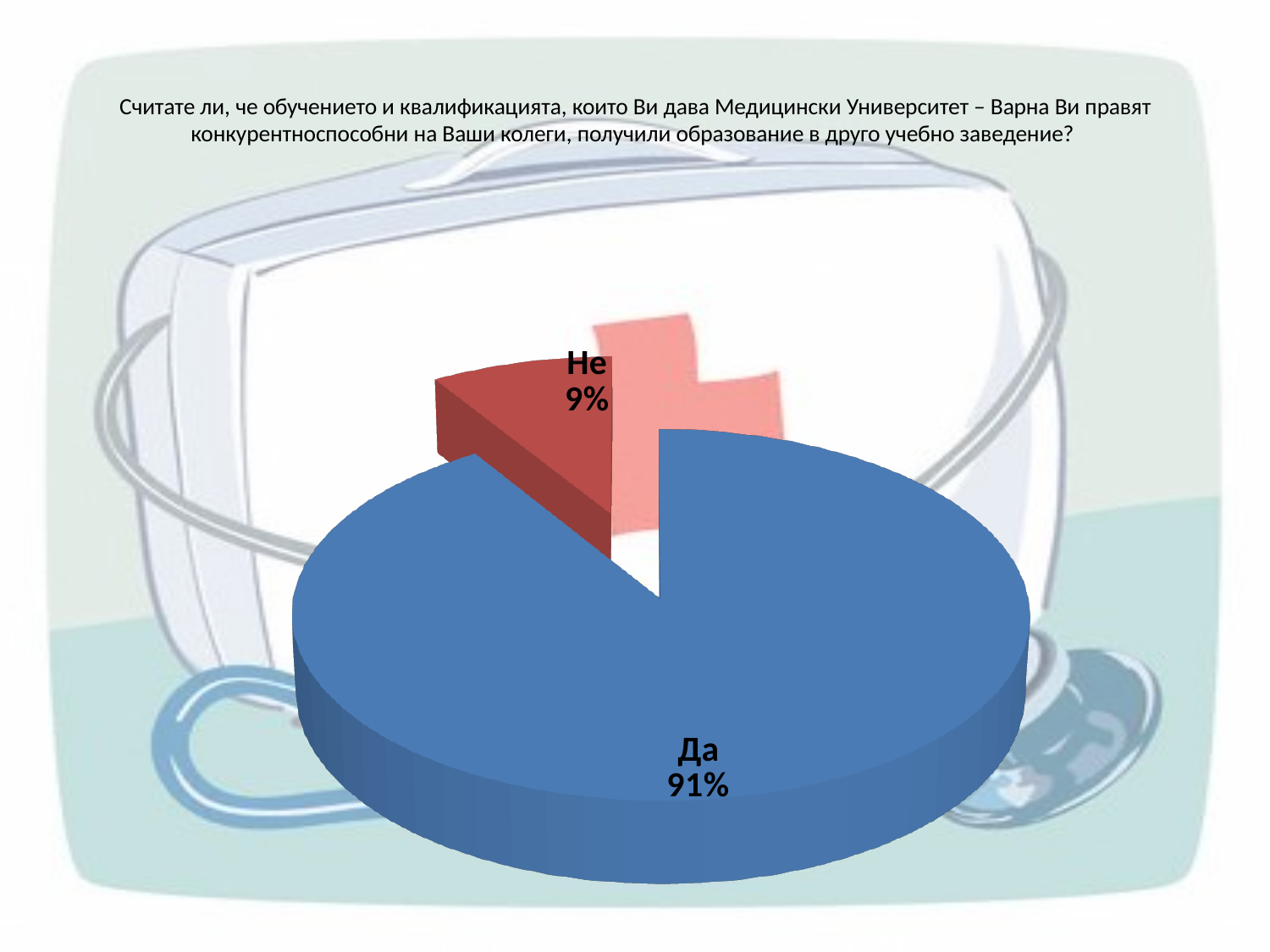
Which is larger, the "Да" slice or the "Не" slice? Да What colour is the "Да" slice? Blue What share of the pie does the "Не" slice represent? 9% What colour is the "Не" slice? Red What share of the pie does the "Да" slice represent? 91% What is the difference in percentage points between the "Да" and "Не" slices? 82 What kind of chart is shown on the slide? Pie chart Which slice is the smallest in the pie chart? Не How many slices does the pie chart have? 2 Which slice is the largest in the pie chart? Да